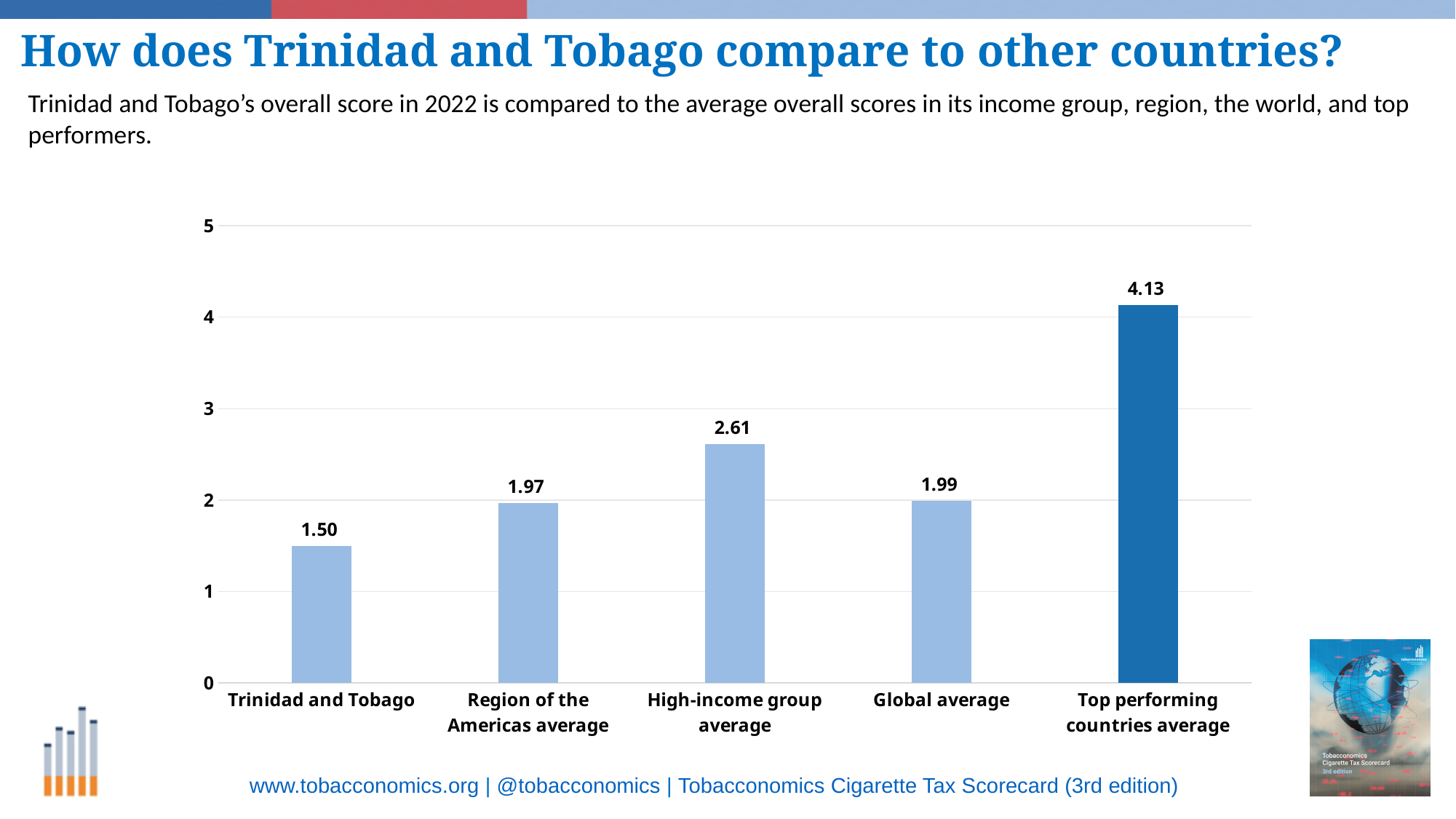
What is the value for the Global average? 1.99 Which is larger, the High-income group average or the Region of the Americas average? High-income group average What is the value for the Top performing countries average? 4.13 What is the value for the Region of the Americas average? 1.97 What is the value for Trinidad and Tobago? 1.50 What is the value for the High-income group average? 2.61 What is the difference between the Top performing countries average and Trinidad and Tobago? 2.63 Which category has the lowest value? Trinidad and Tobago How many categories are shown in the chart? 5 Which category has the highest value? Top performing countries average What is the difference between the High-income group average and the Global average? 0.62 What kind of chart is shown on the slide? Bar chart